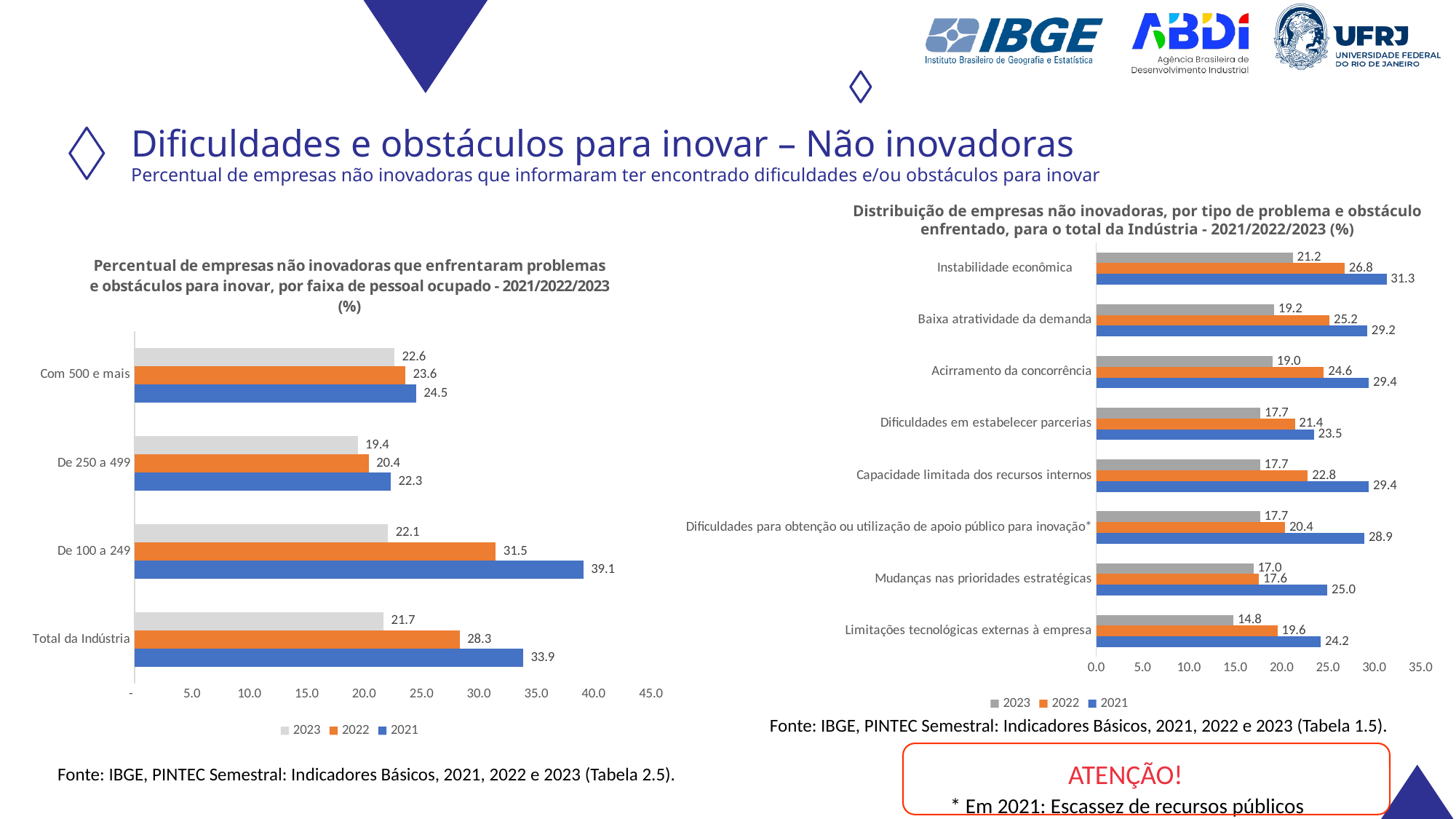
In the right chart (por tipo de problema e obstáculo), which category has the lowest 2023 value? Limitações tecnológicas externas à empresa In the left chart (by faixa de pessoal ocupado), what is the 2021 value for 'De 100 a 249'? 39.1 In the right chart (por tipo de problema e obstáculo), what is the 2022 value for 'Capacidade limitada dos recursos internos'? 22.8 In the left chart (by faixa de pessoal ocupado), what is the 2023 value for 'Total da Indústria'? 21.7 In the left chart (by faixa de pessoal ocupado), how many categories are shown on the vertical axis? 4 In the right chart (por tipo de problema e obstáculo), which is larger: the 2021 value for 'Mudanças nas prioridades estratégicas' or the 2021 value for 'Limitações tecnológicas externas à empresa'? Mudanças nas prioridades estratégicas In the left chart (by faixa de pessoal ocupado), which category has the highest 2022 value? De 100 a 249 What type of chart is the left chart (by faixa de pessoal ocupado)? Bar chart In the right chart (por tipo de problema e obstáculo), how many series does the legend list? 3 In the left chart (by faixa de pessoal ocupado), what is the difference between the 2021 and 2023 values for 'De 100 a 249'? 17.0 In the right chart (por tipo de problema e obstáculo), what is the 2021 value for 'Instabilidade econômica'? 31.3 In the right chart (por tipo de problema e obstáculo), how many categories are shown on the vertical axis? 8